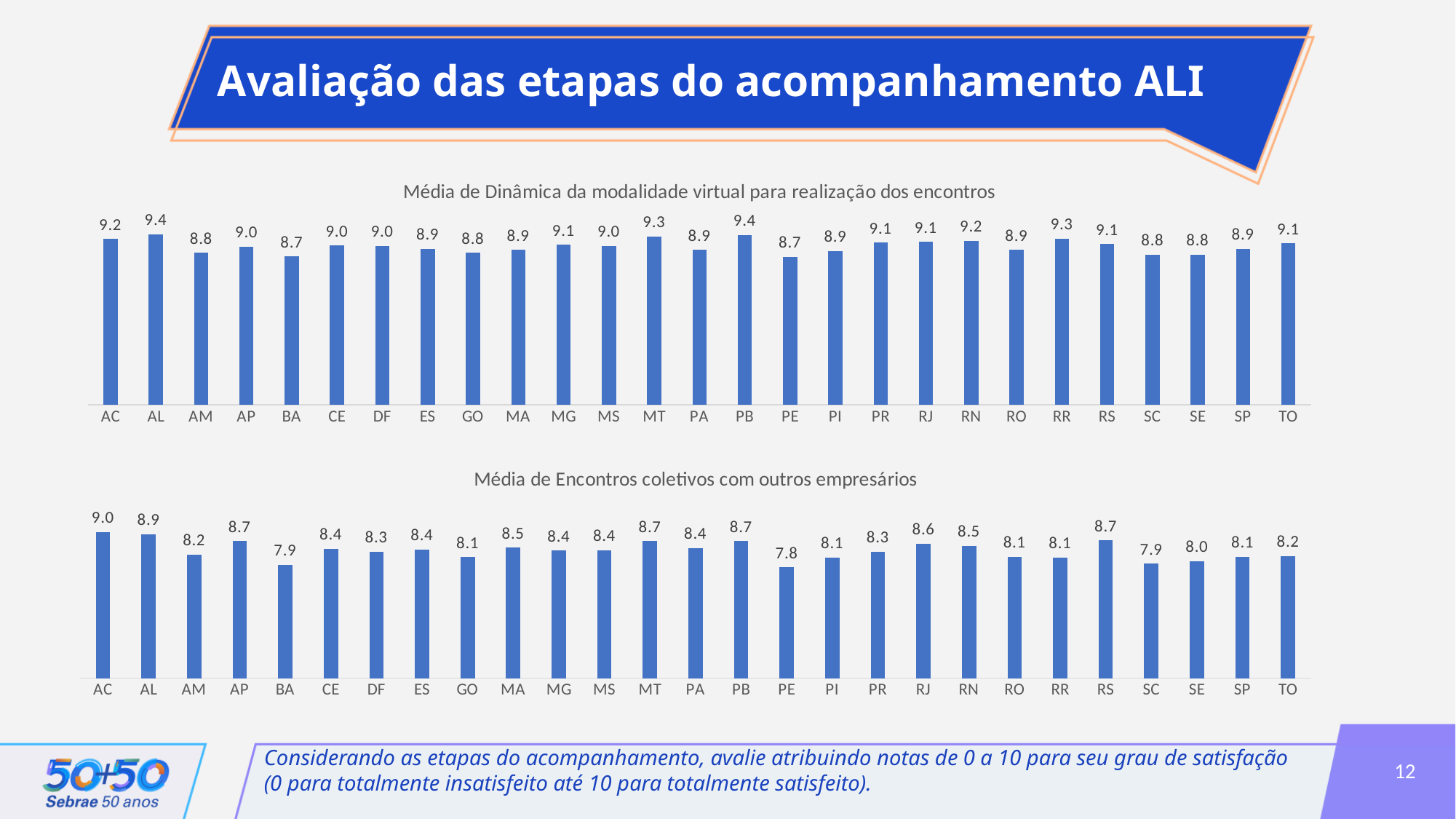
In the chart 'Média de Encontros coletivos com outros empresários', what is the value for RJ? 8.6 In the chart 'Média de Encontros coletivos com outros empresários', which state has the highest value? AC In the chart 'Média de Dinâmica da modalidade virtual para realização dos encontros', what is the value for MT? 9.3 How many states are shown in the chart 'Média de Encontros coletivos com outros empresários'? 27 In the chart 'Média de Encontros coletivos com outros empresários', what is the value for BA? 7.9 In the chart 'Média de Dinâmica da modalidade virtual para realização dos encontros', which is larger, the value for RR or the value for SC? RR In the chart 'Média de Encontros coletivos com outros empresários', what is the difference between the values for AC and PE? 1.2 In the chart 'Média de Encontros coletivos com outros empresários', which state has the lowest value? PE In the chart 'Média de Dinâmica da modalidade virtual para realização dos encontros', what is the value for SP? 8.9 What type of chart is the top chart on the slide? Bar chart In the chart 'Média de Dinâmica da modalidade virtual para realização dos encontros', what is the difference between the values for AL and BA? 0.7 In the chart 'Média de Encontros coletivos com outros empresários', which is larger, the value for AP or the value for GO? AP